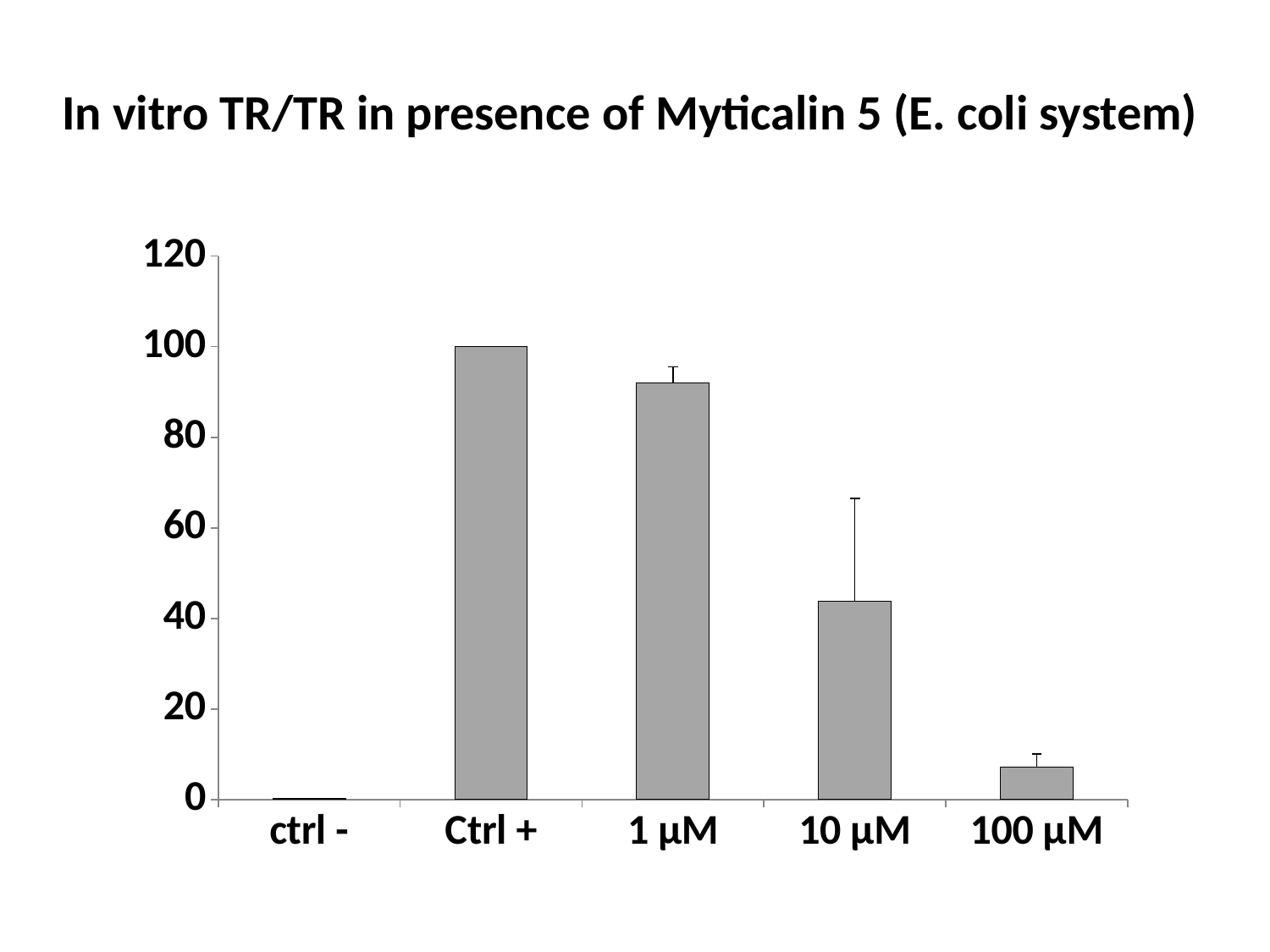
Which category has the highest bar in the chart? Ctrl + What is the value of the Ctrl + bar? 100 Is the value for 100 µM greater or less than 20? less Which category has the lowest bar in the chart? ctrl - Is the value for 10 µM greater or less than 60? less How many categories are shown on the x axis of the chart? 5 What kind of chart is shown on the slide? bar chart Do the values rise or fall as the concentration increases from 1 µM to 100 µM? fall Which is larger, the value for 10 µM or the value for 100 µM? 10 µM Is the value for 1 µM greater or less than 80? greater Which is larger, the value for 1 µM or the value for 10 µM? 1 µM What is the title of the chart? In vitro TR/TR in presence of Myticalin 5 (E. coli system)